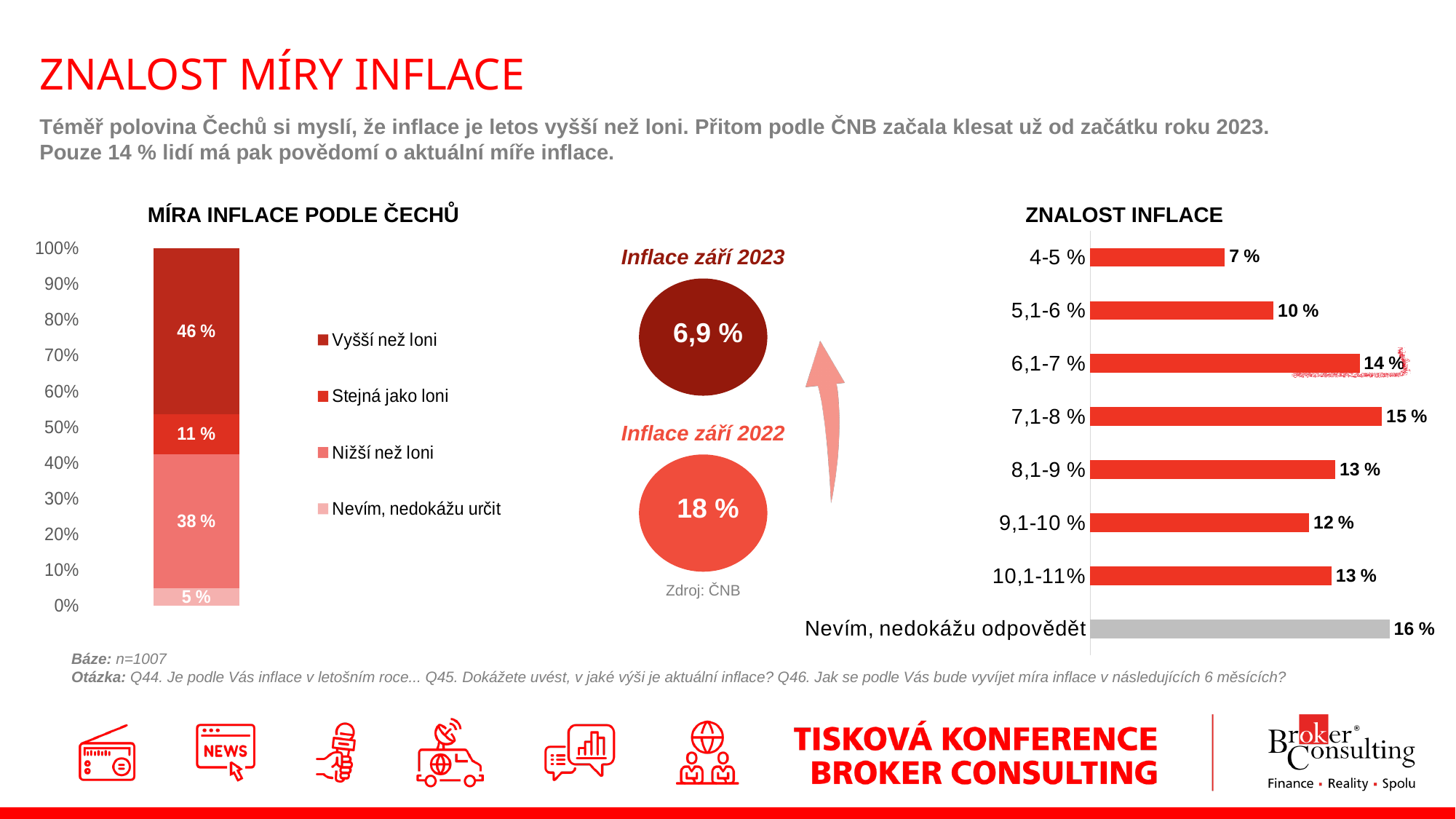
In the chart 'MÍRA INFLACE PODLE ČECHŮ', how many entries does the legend list? 4 In the chart 'ZNALOST INFLACE', which category has the highest value? Nevím, nedokážu odpovědět In the chart 'ZNALOST INFLACE', what is the value for '4-5 %'? 7 % In the chart 'MÍRA INFLACE PODLE ČECHŮ', what share of respondents answered 'Vyšší než loni'? 46 % In the chart 'ZNALOST INFLACE', which category has the lowest value? 4-5 % How many categories are shown in the chart 'ZNALOST INFLACE'? 8 In the chart 'ZNALOST INFLACE', what is the value for '7,1-8 %'? 15 % In the chart 'ZNALOST INFLACE', which is larger: the value for '5,1-6 %' or the value for '6,1-7 %'? 6,1-7 % In the chart 'MÍRA INFLACE PODLE ČECHŮ', which segment is the smallest? Nevím, nedokážu určit What type of chart is 'ZNALOST INFLACE'? Bar chart In the chart 'MÍRA INFLACE PODLE ČECHŮ', what is the value for 'Nižší než loni'? 38 % In the chart 'MÍRA INFLACE PODLE ČECHŮ', what is the difference between 'Vyšší než loni' and 'Nižší než loni'? 8 %